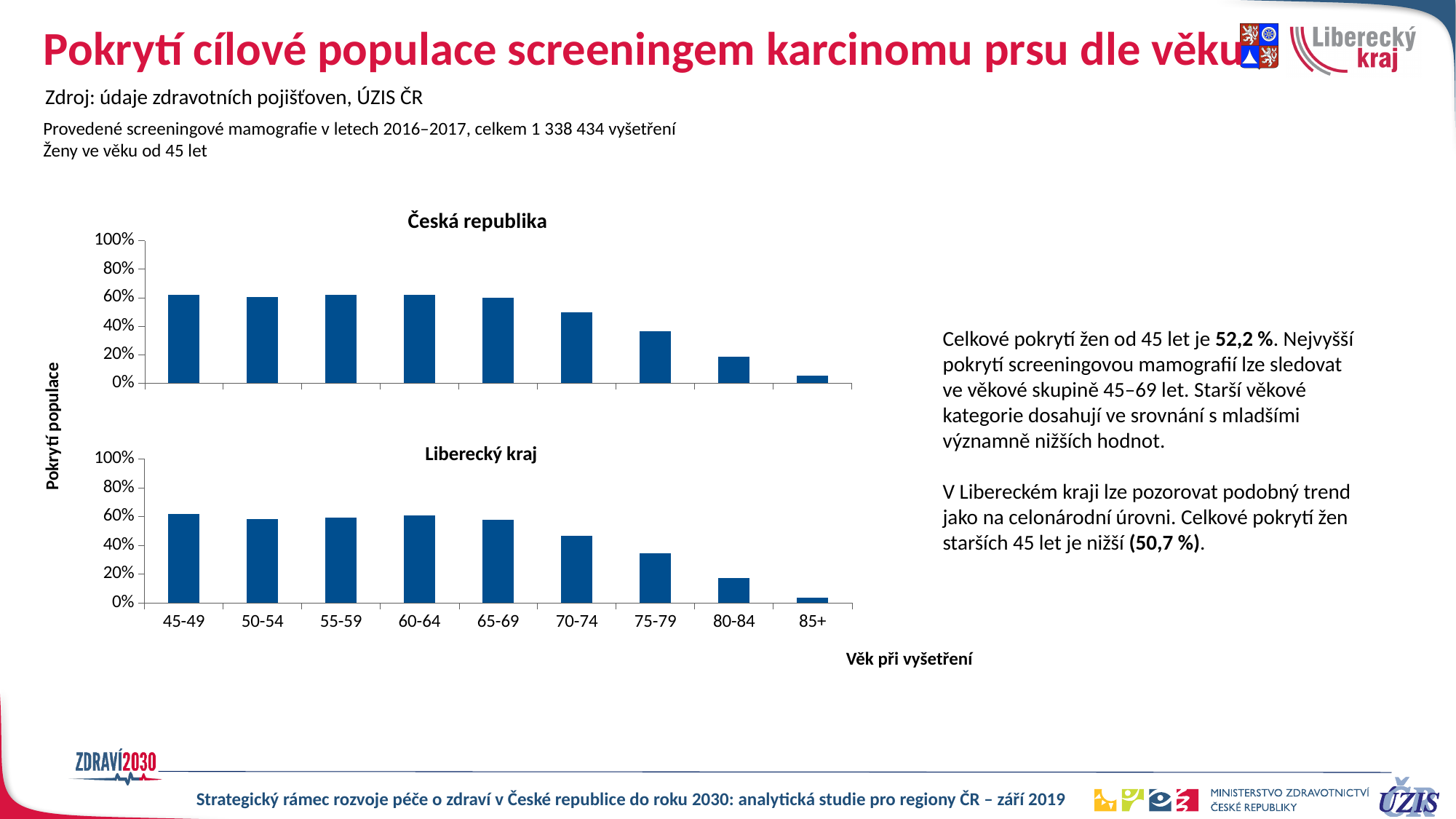
What is the label of the x axis shared by the two charts? Věk při vyšetření In the "Česká republika" chart, is the value for 70-74 greater or less than 40%? greater In the "Česká republika" chart, is the value for 75-79 greater or less than 40%? less What is the title of the upper chart on the slide? Česká republika What kind of chart is the "Česká republika" chart? bar chart In the "Česká republika" chart, do the values generally rise or fall from the 65-69 category to the 85+ category? fall In the "Liberecký kraj" chart, is the value for 85+ greater or less than 20%? less How many age categories are shown on the x axis of the "Liberecký kraj" chart? 9 In the "Liberecký kraj" chart, which is larger, the value for 70-74 or the value for 75-79? 70-74 In the "Liberecký kraj" chart, which age category has the lowest coverage? 85+ In the "Česká republika" chart, which age category has the lowest coverage? 85+